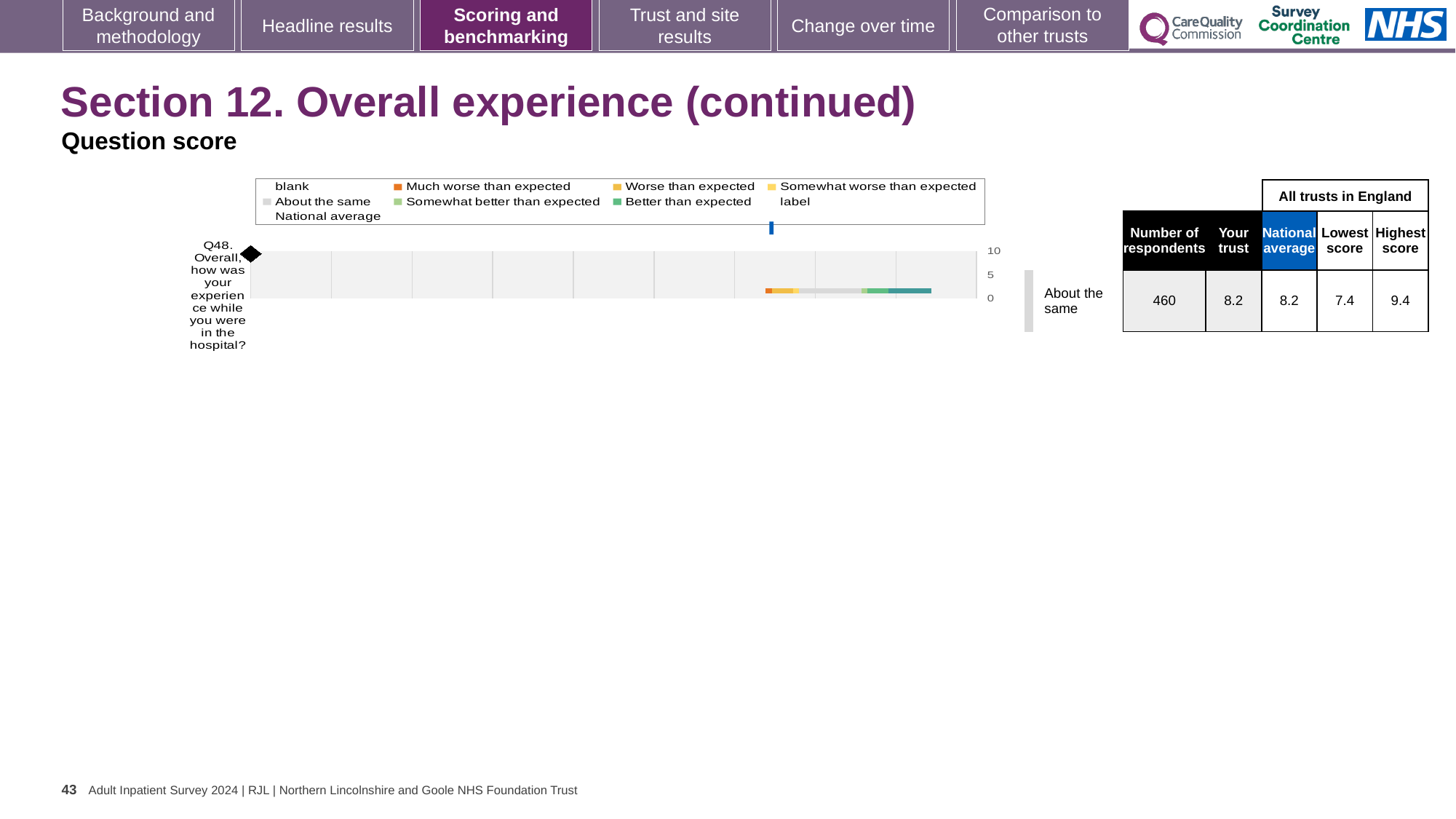
According to the table next to the chart, what is the Highest score among all trusts in England for Q48? 9.4 What benchmarking category is the trust's Q48 score placed in, as labelled beside the chart? About the same According to the table next to the chart, what is the National average score for Q48? 8.2 Is the Your trust score for Q48 higher than, lower than, or the same as the National average? the same According to the table next to the chart, what is the score for Your trust for Q48? 8.2 According to the table next to the chart, what is the Lowest score among all trusts in England for Q48? 7.4 What kind of chart is shown on the slide? bar chart Which question is plotted on the chart? Q48. Overall, how was your experience while you were in the hospital? What is the difference between the Highest score and the Lowest score for Q48 in the table next to the chart? 2.0 According to the table next to the chart, how many respondents answered Q48? 460 What is the highest value shown on the chart's axis? 10 How many questions (categories) are plotted on the chart? 1